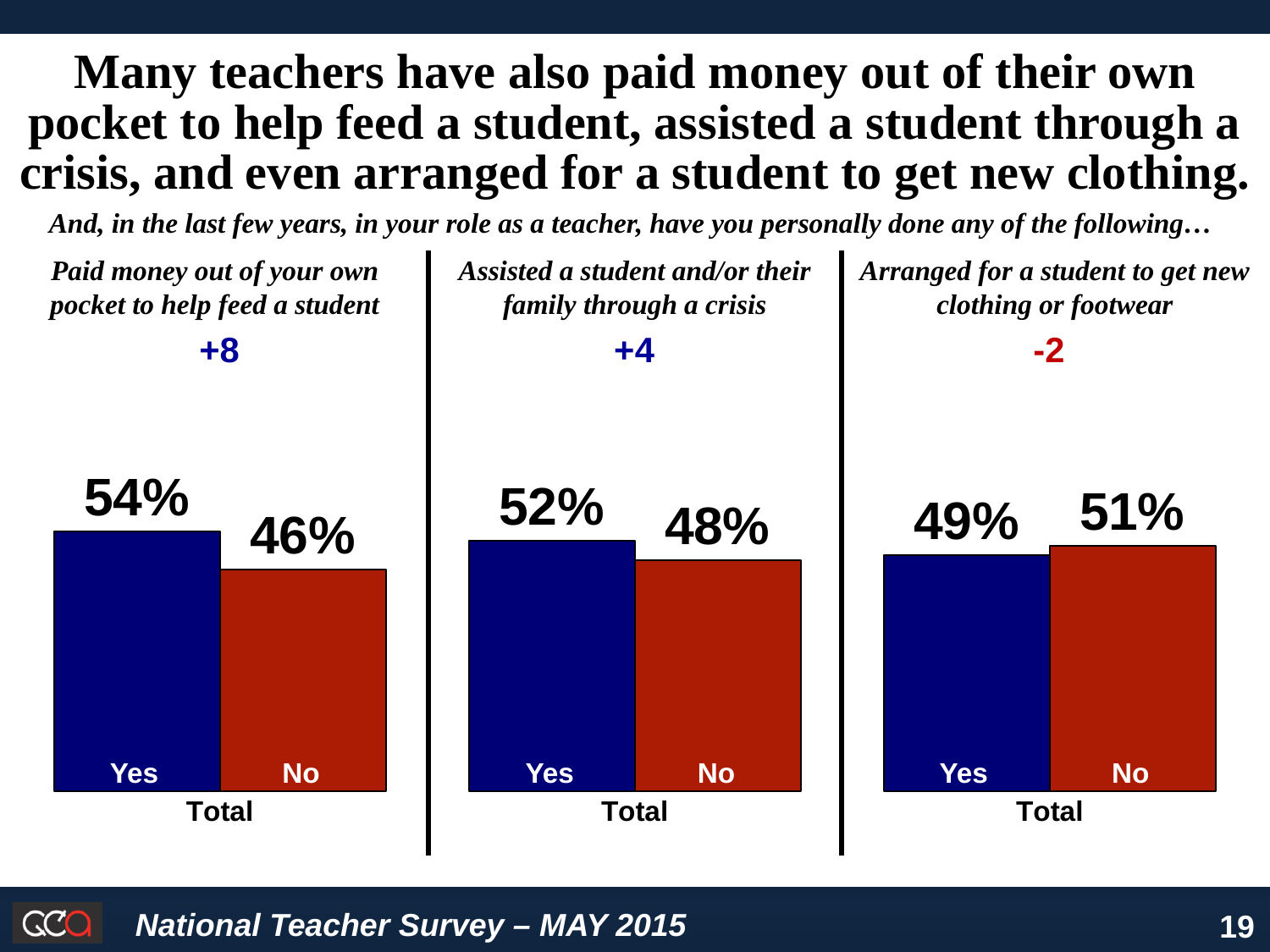
In the chart 'Paid money out of your own pocket to help feed a student', what percentage answered Yes? 54% In the chart 'Paid money out of your own pocket to help feed a student', what percentage answered No? 46% In the chart 'Assisted a student and/or their family through a crisis', which response has the higher percentage? Yes In the chart 'Paid money out of your own pocket to help feed a student', what is the difference between the Yes and No percentages? 8% In the chart 'Assisted a student and/or their family through a crisis', what is the difference between the Yes and No percentages? 4% What colour is the Yes bar in the chart 'Assisted a student and/or their family through a crisis'? Blue How many bars are shown in the chart 'Arranged for a student to get new clothing or footwear'? 2 In the chart 'Arranged for a student to get new clothing or footwear', what percentage answered No? 51% What kind of chart is used in the 'Paid money out of your own pocket to help feed a student' panel? Bar chart In the chart 'Assisted a student and/or their family through a crisis', what percentage answered Yes? 52% In the chart 'Arranged for a student to get new clothing or footwear', which is larger, Yes or No? No In the chart 'Arranged for a student to get new clothing or footwear', what percentage answered Yes? 49%